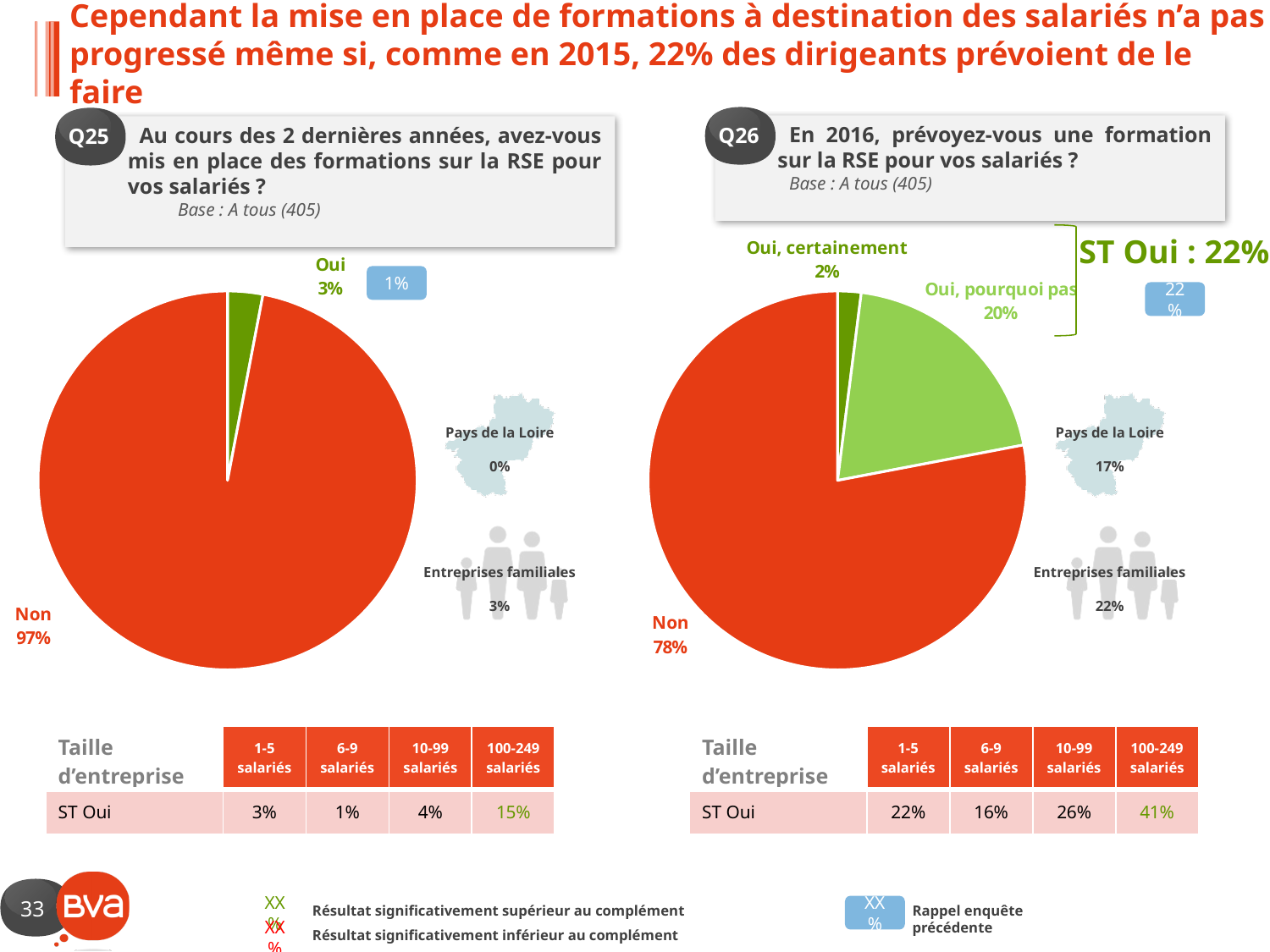
In the right pie chart (Q26), what percentage answered "Non"? 78% In the right pie chart (Q26), which slice is the largest? Non In the left pie chart (Q25), what percentage of respondents answered "Non"? 97% What is the difference between the "Non" share in the left pie chart (Q25) and the "Non" share in the right pie chart (Q26)? 19 percentage points In the right pie chart (Q26), what percentage answered "Oui, certainement"? 2% What is the "ST Oui" total shown for the right pie chart (Q26)? 22% In the right pie chart (Q26), which slice is the smallest? Oui, certainement How many slices does the right pie chart (Q26) have? 3 What type of chart is used for Q25 on the left? Pie chart In the right pie chart (Q26), what percentage answered "Oui, pourquoi pas"? 20% In the left pie chart (Q25), what percentage of respondents answered "Oui"? 3% Which is larger: the "Oui" share in the left pie chart (Q25) or the "Oui, pourquoi pas" share in the right pie chart (Q26)? Oui, pourquoi pas (Q26)